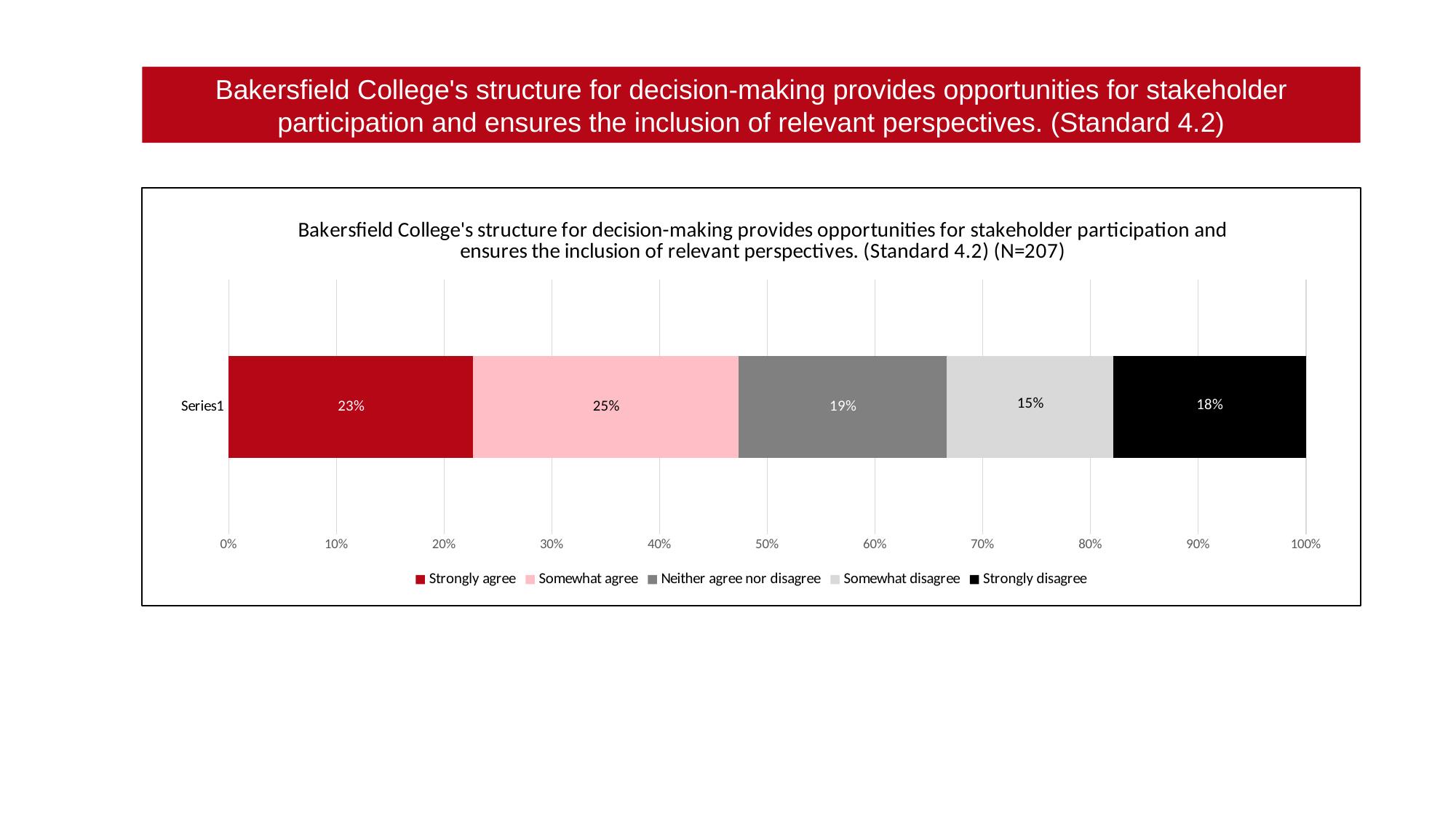
What kind of chart is shown on the slide? Stacked bar chart What percentage of respondents selected Strongly disagree? 18% What is the sample size (N) stated in the chart title? 207 Which response option has the smallest share? Somewhat disagree What is the difference between the Somewhat agree and Strongly disagree percentages? 7% What percentage of respondents selected Somewhat agree? 25% Which is larger, the share for Strongly agree or the share for Neither agree nor disagree? Strongly agree What percentage of respondents selected Strongly agree? 23% What percentage of respondents selected Neither agree nor disagree? 19% How many series does the legend list? 5 What percentage of respondents selected Somewhat disagree? 15% Which response option has the largest share? Somewhat agree